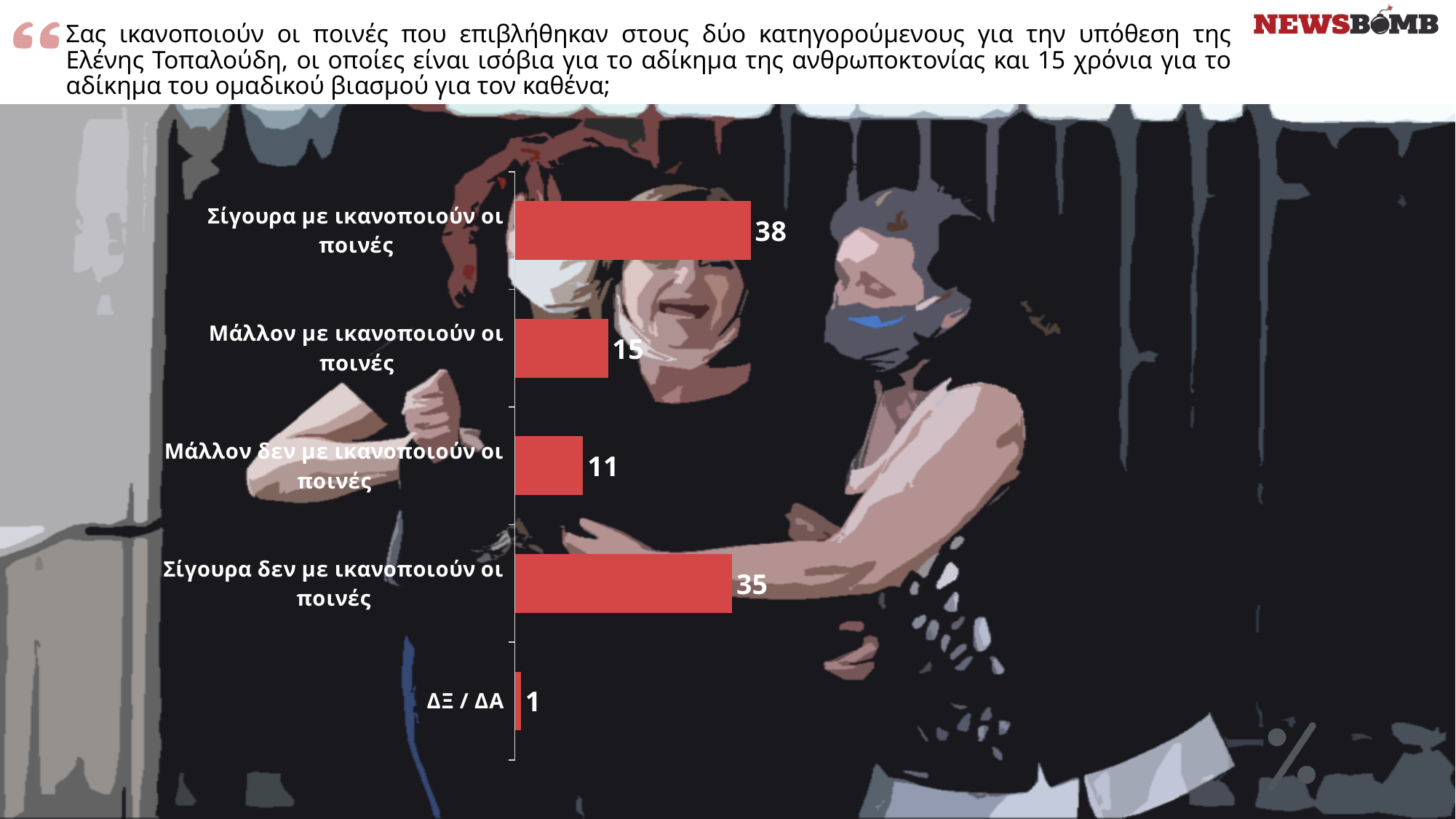
Which category has the lowest value? ΔΞ / ΔΑ Which category has the highest value? Σίγουρα με ικανοποιούν οι ποινές Which is larger, "Μάλλον με ικανοποιούν οι ποινές" or "Μάλλον δεν με ικανοποιούν οι ποινές"? Μάλλον με ικανοποιούν οι ποινές What is the value for "ΔΞ / ΔΑ"? 1 What kind of chart is shown on the slide? bar chart What colour are the bars in the chart? red What is the difference between "Σίγουρα με ικανοποιούν οι ποινές" and "Σίγουρα δεν με ικανοποιούν οι ποινές"? 3 How many categories are shown in the chart? 5 What is the value for "Μάλλον με ικανοποιούν οι ποινές"? 15 What is the value for "Μάλλον δεν με ικανοποιούν οι ποινές"? 11 What is the value for "Σίγουρα με ικανοποιούν οι ποινές"? 38 What is the value for "Σίγουρα δεν με ικανοποιούν οι ποινές"? 35